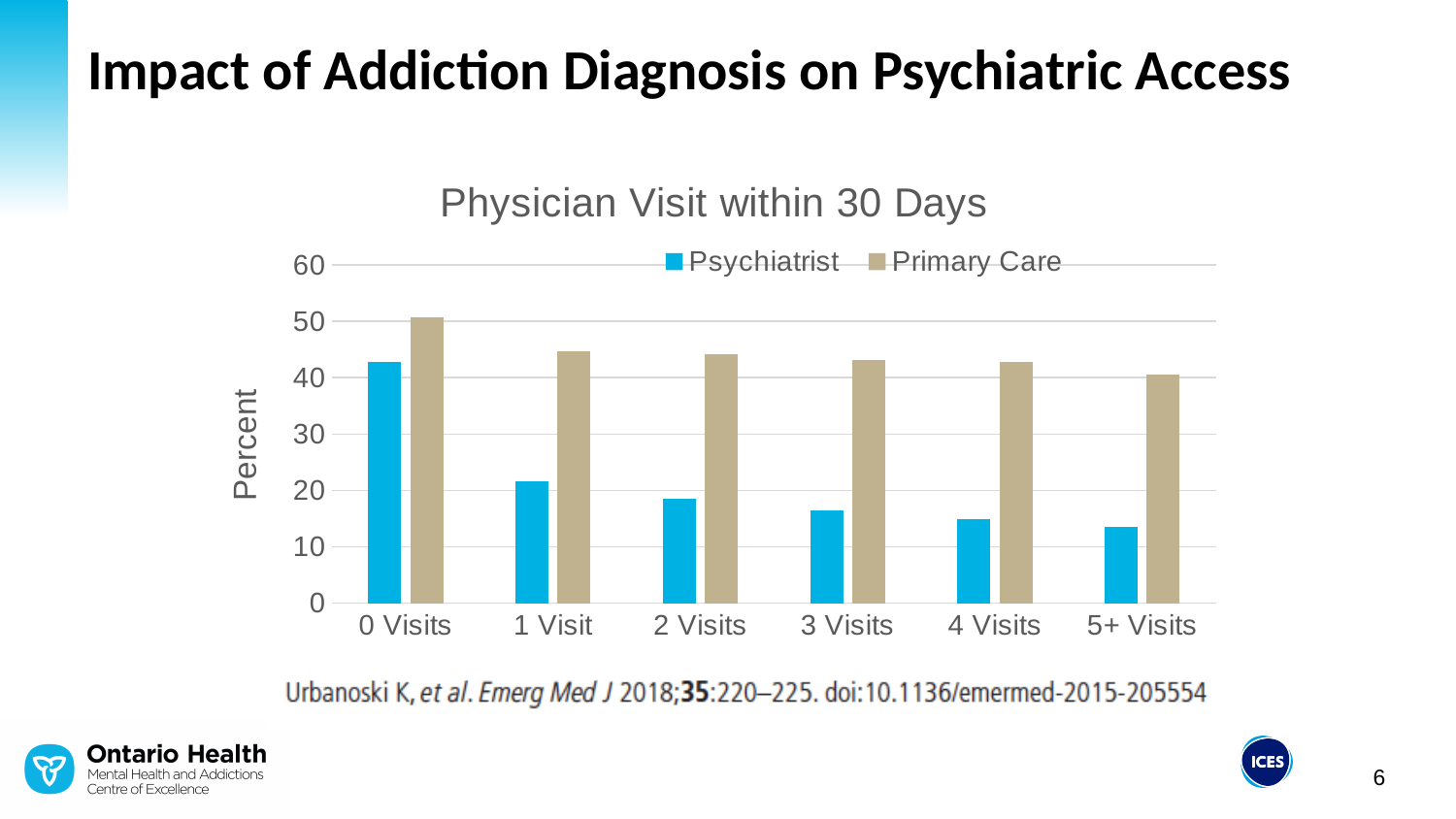
Is the Primary Care value for 5+ Visits greater or less than 30? greater Do the Psychiatrist values rise or fall as the number of visits increases along the x axis? fall Which visit category has the lowest Psychiatrist value? 5+ Visits Which visit category has the highest Psychiatrist value? 0 Visits For 3 Visits, which is larger: Psychiatrist or Primary Care? Primary Care What is the title of the chart? Physician Visit within 30 Days What kind of chart is shown on the slide? bar chart Is the Psychiatrist value for 0 Visits greater or less than 40? greater How many visit categories are shown on the x axis? 6 Is the Psychiatrist value for 5+ Visits greater or less than 20? less Which visit category has the highest Primary Care value? 0 Visits How many series does the legend list? 2